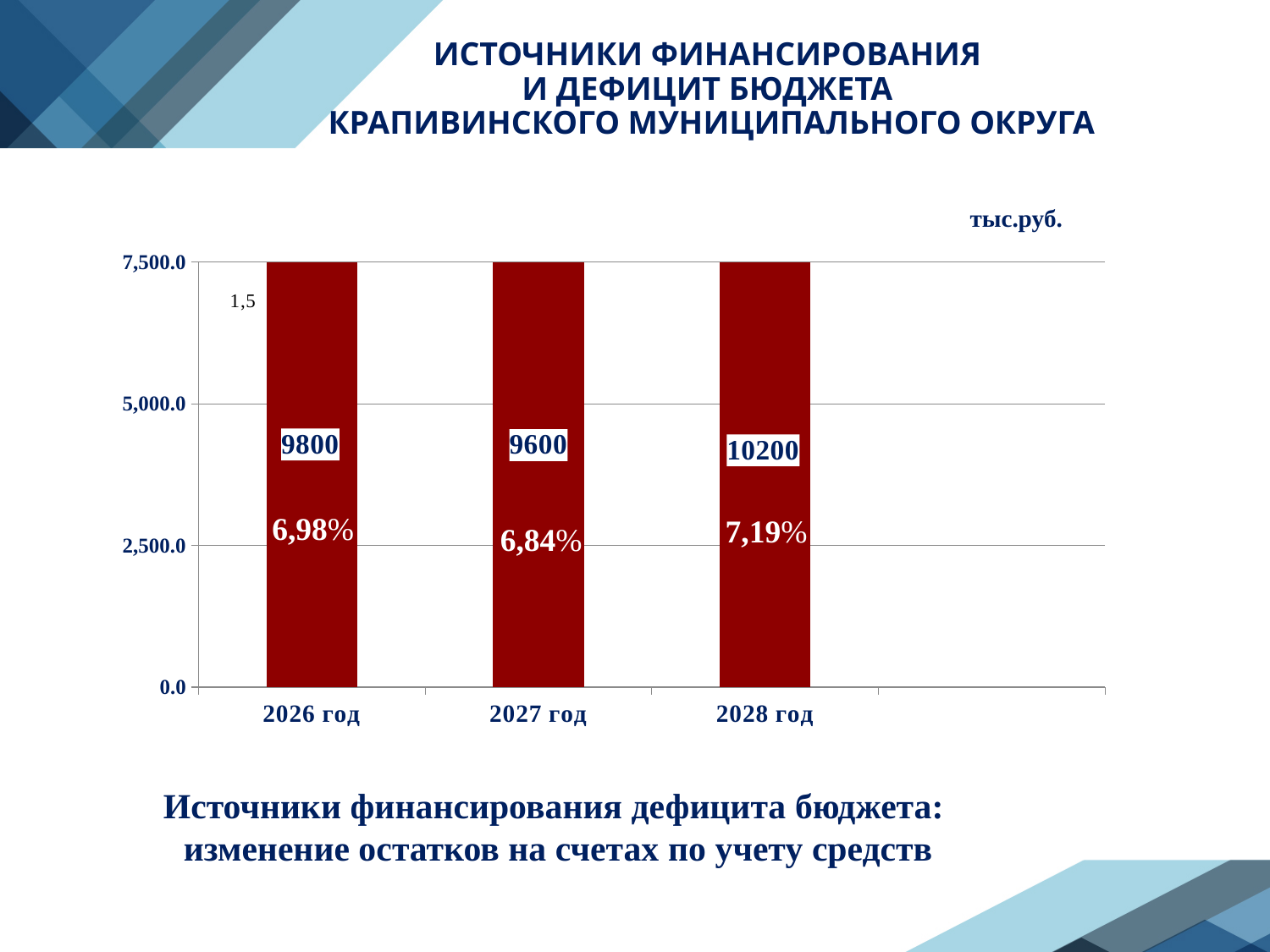
Which is larger, the labelled value for 2026 год or for 2027 год? 2026 год What value is labelled on the bar for 2026 год? 9800 What value is labelled on the bar for 2028 год? 10200 What kind of chart is shown on the slide? bar chart What value is labelled on the bar for 2027 год? 9600 Which year has the lowest labelled value? 2027 год What percentage is shown on the bar for 2026 год? 6,98% What unit is stated above the chart? тыс.руб. What is the difference between the labelled values for 2028 год and 2027 год? 600 Which year has the highest labelled value? 2028 год How many years are shown on the x axis? 3 What percentage is shown on the bar for 2028 год? 7,19%